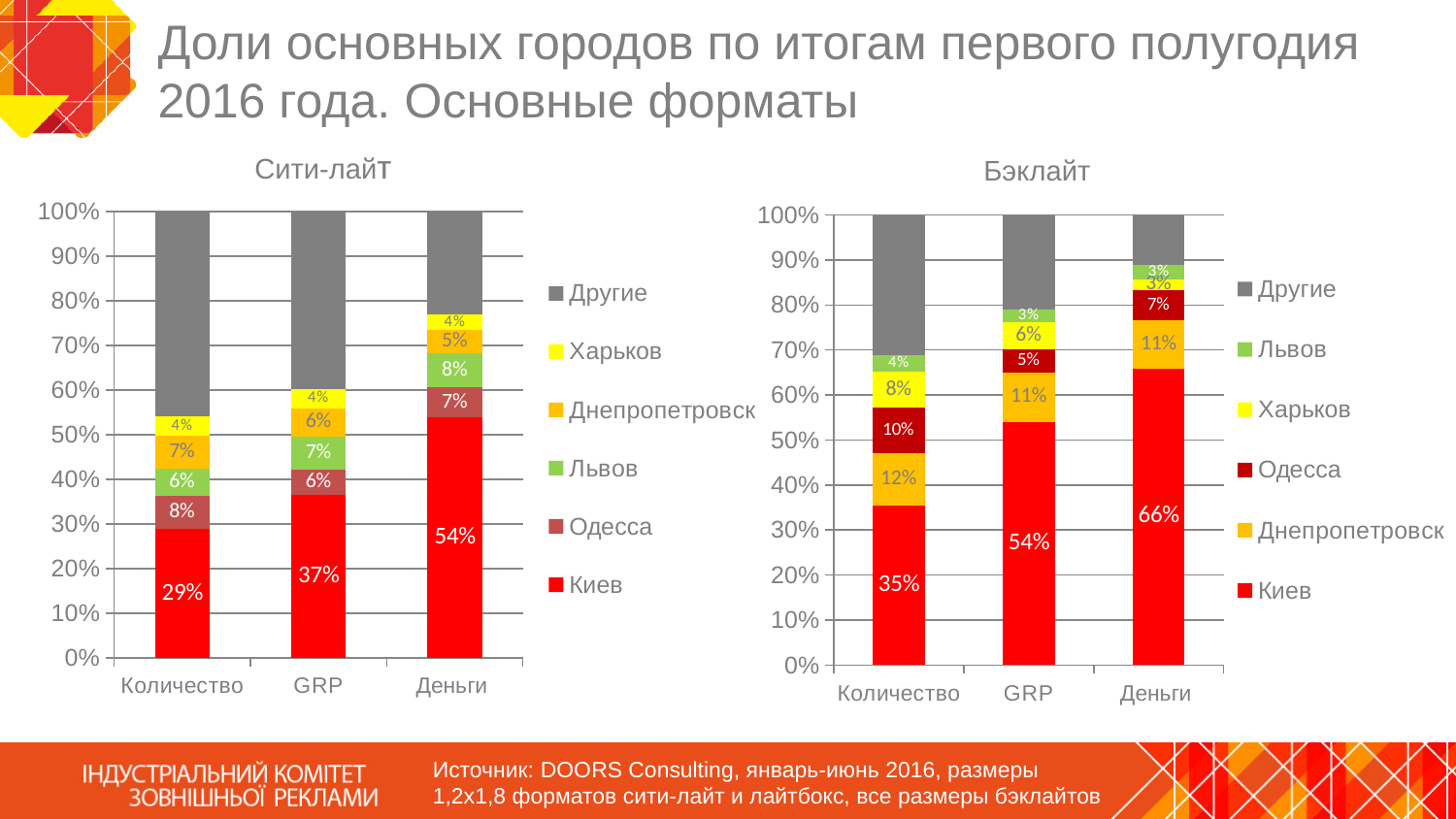
In the Сити-лайт chart, which category has the lowest value for Киев? Количество In the Сити-лайт chart, which is larger: Львов in the Деньги bar or Львов in the GRP bar? Львов in the Деньги bar In the Сити-лайт chart, does the Киев value for Деньги rise or fall compared with Количество? rise In the Сити-лайт chart, what is the value for Киев in the Деньги bar? 54% In the Бэклайт chart, which category has the highest value for Киев? Деньги What kind of chart is the Бэклайт chart? stacked bar chart How many categories are shown on the x axis of the Бэклайт chart? 3 In the Бэклайт chart, what is the value for Киев in the GRP bar? 54% How many series does the legend of the Сити-лайт chart list? 6 In the Сити-лайт chart, what is the value for Одесса in the Количество bar? 8% In the Бэклайт chart, what is the difference between the Киев values for Деньги and Количество? 31% In the Бэклайт chart, what is the value for Днепропетровск in the Количество bar? 12%